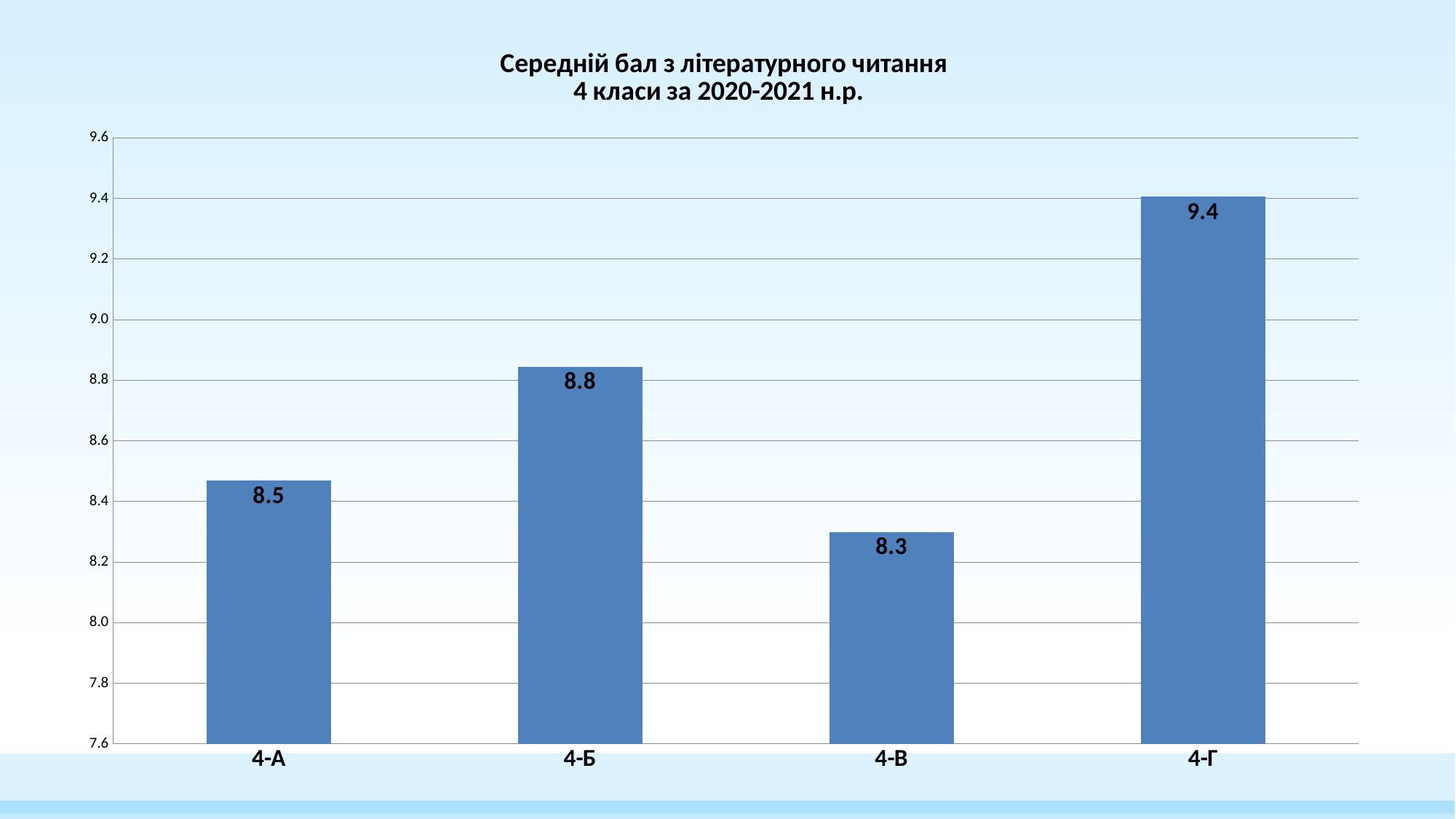
Which is larger, the value for 4-А or the value for 4-Б? 4-Б Which class has the lowest average score? 4-В What kind of chart is shown on the slide? bar chart What is the difference between the values for 4-Г and 4-В? 1.1 Which class has the highest average score? 4-Г What is the value for 4-Б? 8.8 What is the value for 4-Г? 9.4 How many classes are shown on the chart? 4 What is the title of the chart? Середній бал з літературного читання 4 класи за 2020-2021 н.р. What is the value for 4-В? 8.3 Is the value for 4-Б greater or less than 9.0? less What is the value for 4-А? 8.5